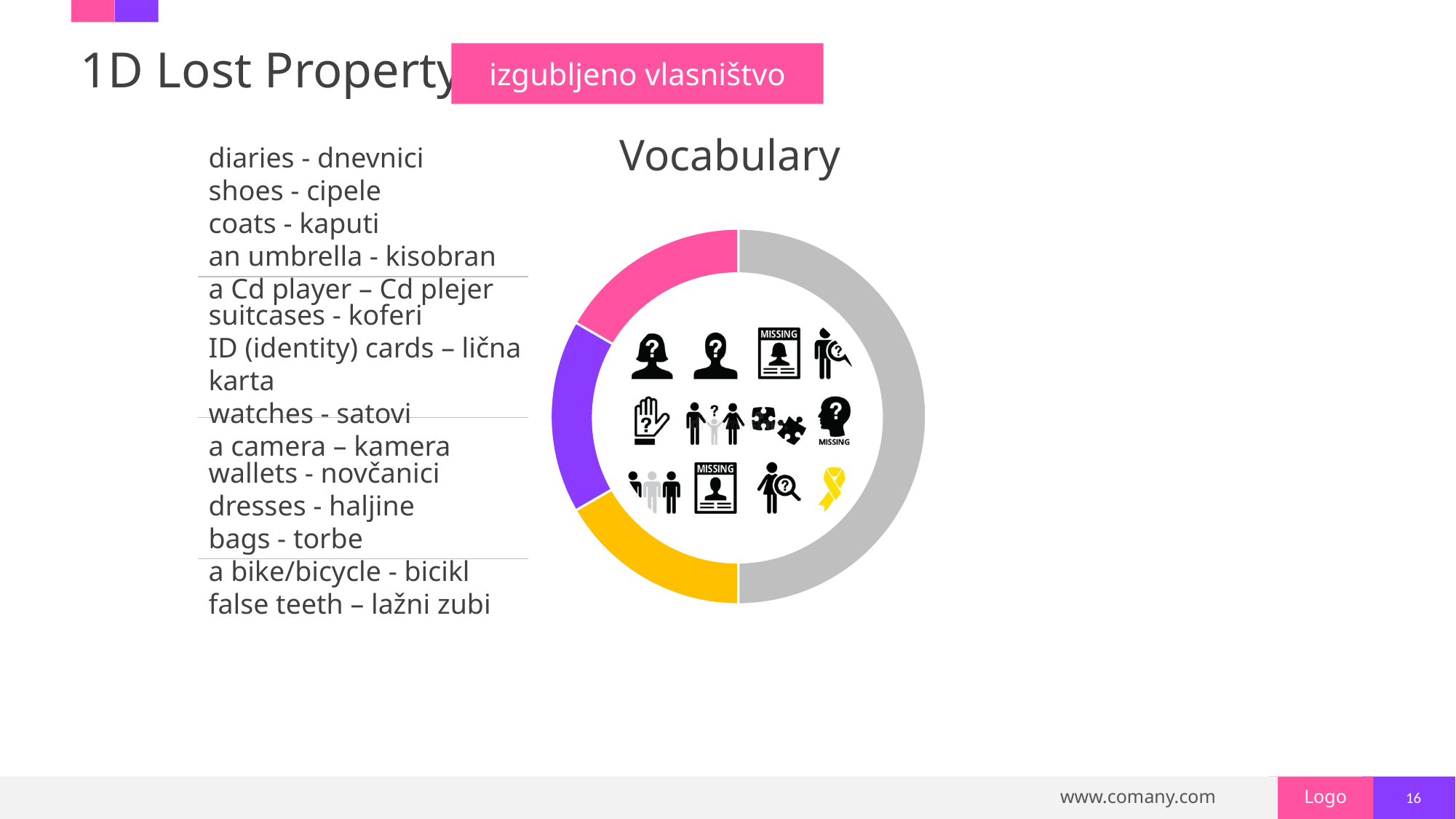
What colours are the four segments of the doughnut chart? pink, purple, yellow and gray Does the doughnut chart have a legend? No Is the gray segment of the doughnut chart larger or smaller than the yellow segment? larger Which colour segment of the doughnut chart is the largest? gray What kind of chart is shown on the slide? doughnut chart Is the gray segment of the doughnut chart larger or smaller than the pink segment? larger How many segments does the doughnut chart have? 4